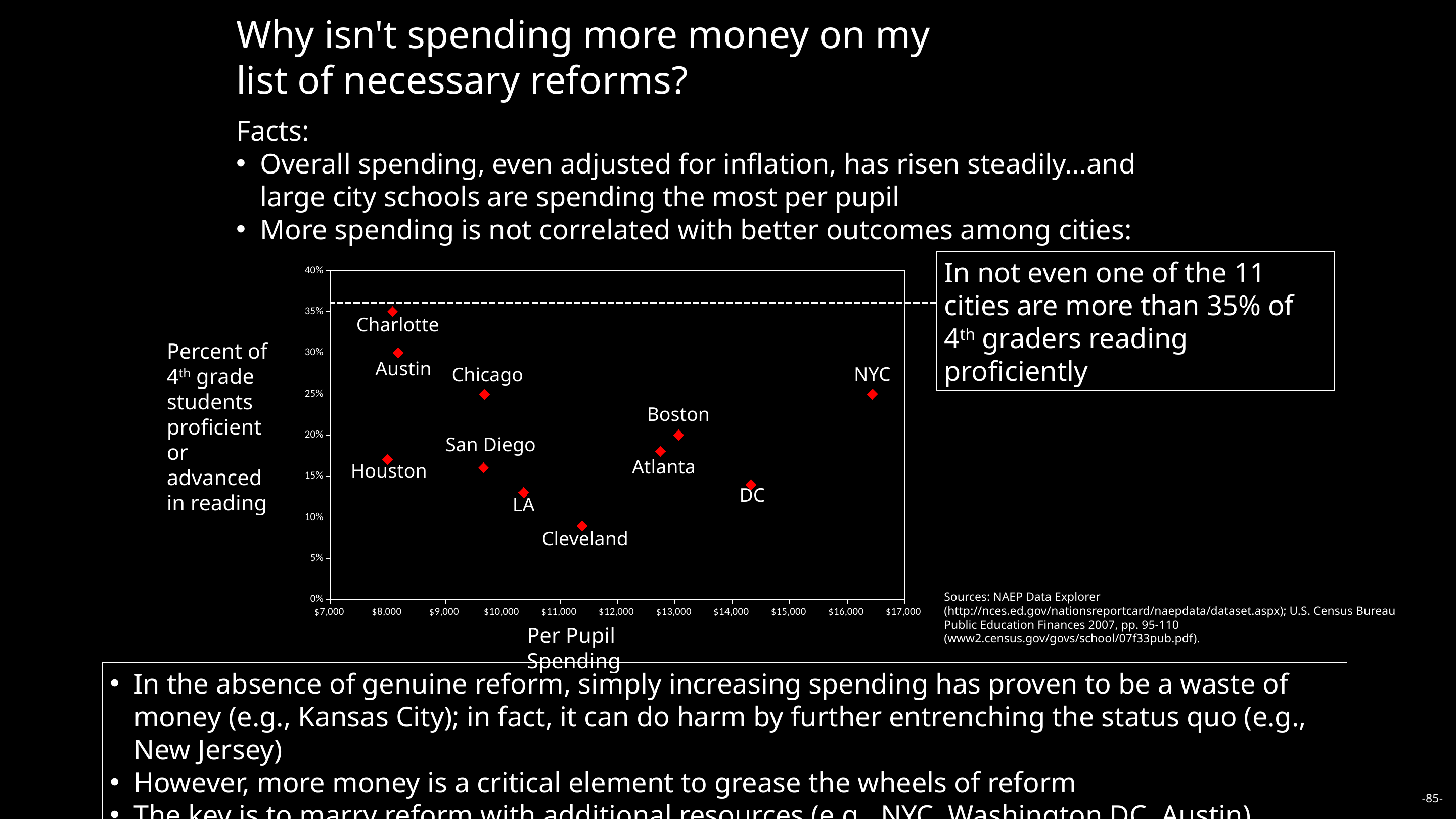
What percent of 4th grade students are proficient or advanced in reading in Austin? 30% Which city has the lowest percent of 4th grade students proficient or advanced in reading? Cleveland Is the reading proficiency value for Cleveland greater or less than 10%? less What is the difference in reading proficiency percentage between Charlotte and Austin? 5% How many cities are plotted on the chart? 11 Is the per pupil spending for NYC greater or less than $16,000? greater What kind of chart is shown on the slide? scatter chart What is the label of the x axis of the chart? Per Pupil Spending What percent of 4th grade students are proficient or advanced in reading in Boston? 20% Which city has a higher reading proficiency percentage, Boston or Chicago? Chicago Which city has the highest percent of 4th grade students proficient or advanced in reading? Charlotte What percent of 4th grade students are proficient or advanced in reading in Charlotte? 35%